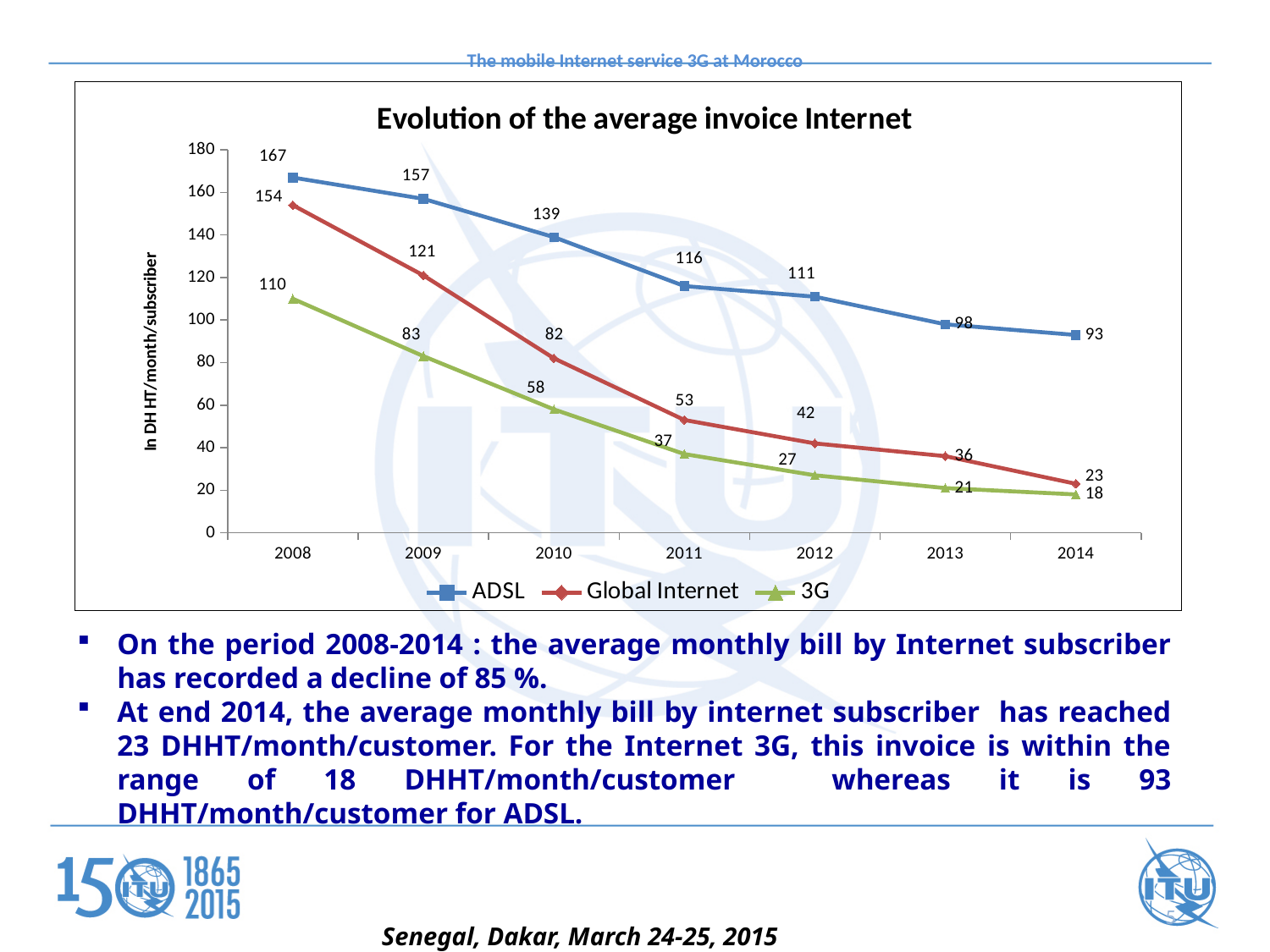
What is the Global Internet value in 2011? 53 How many series does the legend list? 3 Which year has the lowest 3G value? 2014 What kind of chart is this? Line chart Do the Global Internet values rise or fall from 2008 to 2014? Fall What is the difference between the ADSL and 3G values in 2014? 75 What is the 3G value in 2012? 27 Which is larger in 2009: the Global Internet value or the 3G value? Global Internet Which year has the highest ADSL value? 2008 How many years are shown on the x axis? 7 What is the title of the chart? Evolution of the average invoice Internet What is the ADSL value in 2010? 139